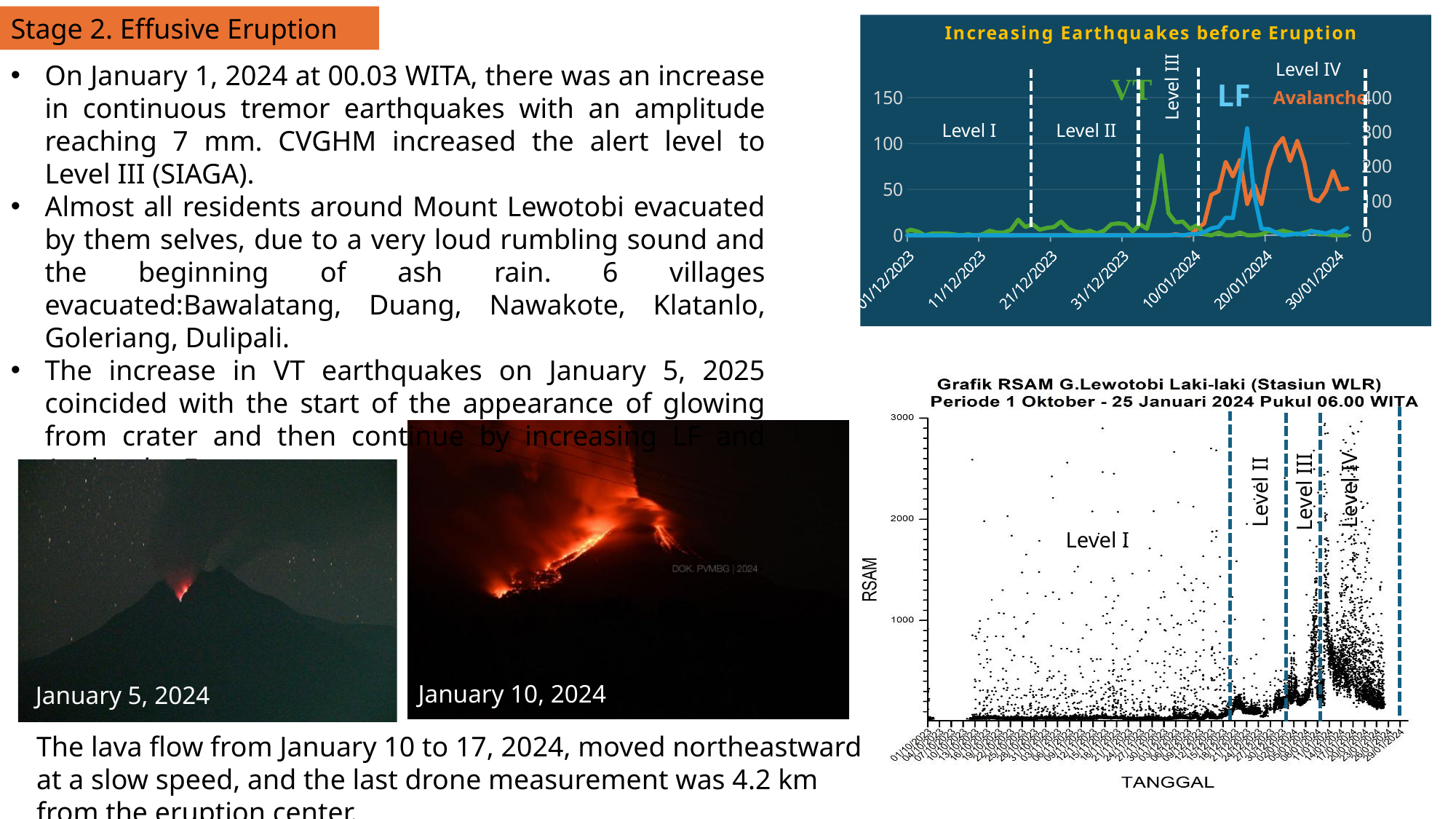
In the 'Increasing Earthquakes before Eruption' chart, what is the highest tick on the right vertical axis? 400 What is the label of the horizontal axis in the bottom-right RSAM chart? TANGGAL In the 'Increasing Earthquakes before Eruption' chart, how many earthquake series are plotted? 3 What is the label of the vertical axis in the bottom-right RSAM chart? RSAM In the 'Increasing Earthquakes before Eruption' chart, what is the last date shown on the x axis? 30/01/2024 In the 'Increasing Earthquakes before Eruption' chart, what is the highest tick on the left vertical axis? 150 What kind of chart is 'Increasing Earthquakes before Eruption'? line chart What is the title of the top-right chart? Increasing Earthquakes before Eruption In the 'Increasing Earthquakes before Eruption' chart, how many alert level zones are marked? 4 In the 'Increasing Earthquakes before Eruption' chart, what is the first date shown on the x axis? 01/12/2023 In the bottom-right RSAM chart, what is the highest tick on the vertical axis? 3000 In the 'Increasing Earthquakes before Eruption' chart, which series is drawn in green? VT